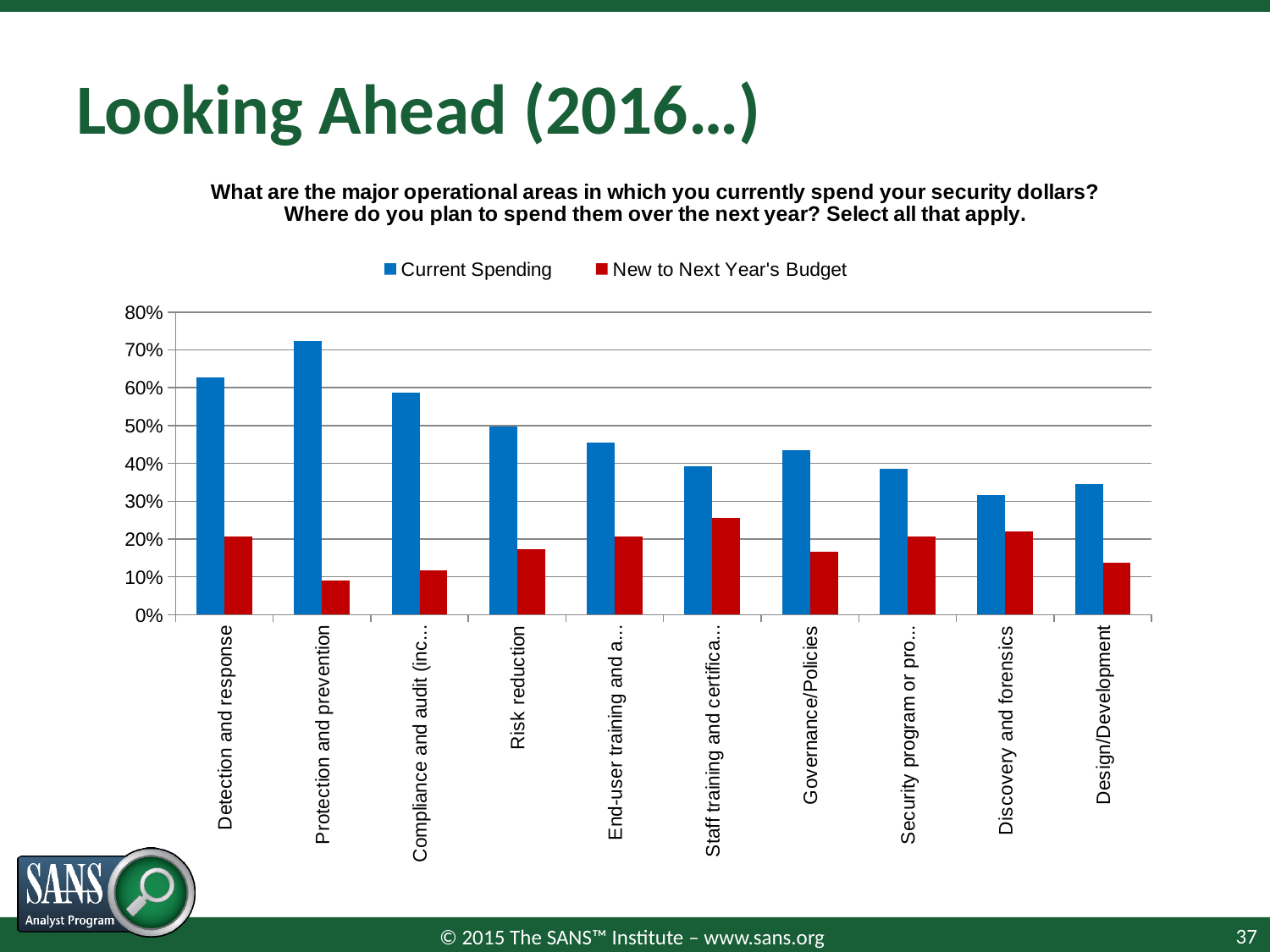
Is the New to Next Year's Budget value for Staff training and certifica... greater or less than 20%? greater How many series does the legend list? 2 Is the New to Next Year's Budget value for Protection and prevention greater or less than 20%? less What kind of chart is shown on the slide? Bar chart What colour are the bars for the Current Spending series? Blue Which category has the highest Current Spending value? Protection and prevention Which is larger: the New to Next Year's Budget value for Staff training and certifica... or for Governance/Policies? Staff training and certifica... Which is larger: the Current Spending value for Detection and response or for Protection and prevention? Protection and prevention Which category has the lowest New to Next Year's Budget value? Protection and prevention Is the Current Spending value for Detection and response greater or less than 50%? greater How many operational area categories are shown on the x axis? 10